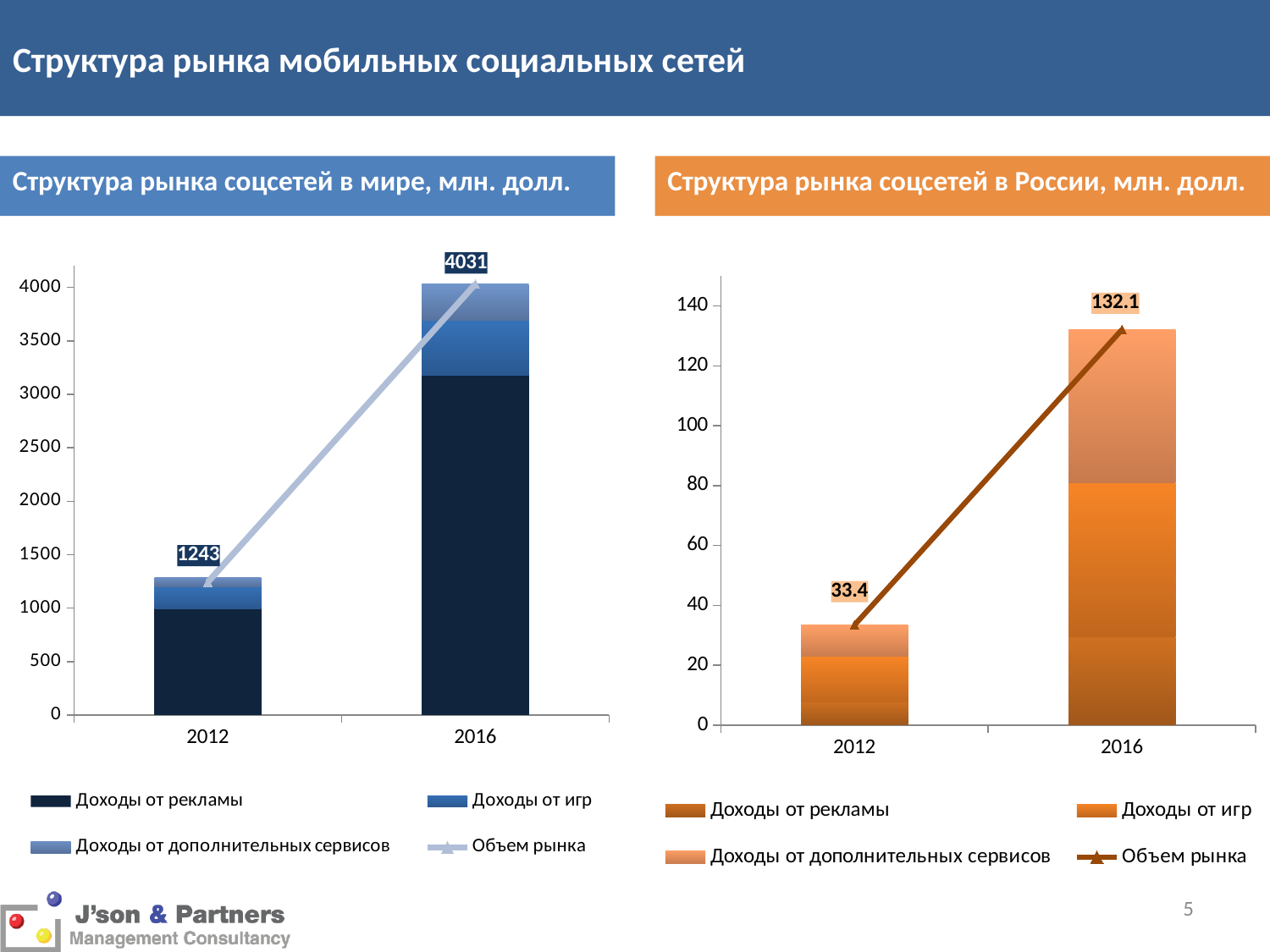
On the chart 'Структура рынка соцсетей в мире, млн. долл.', is the value of Доходы от рекламы for 2016 greater or less than 3000? greater On the chart 'Структура рынка соцсетей в России, млн. долл.', what is the value of Объем рынка for 2016? 132.1 On the chart 'Структура рынка соцсетей в мире, млн. долл.', what is the value of Объем рынка for 2012? 1243 On the chart 'Структура рынка соцсетей в России, млн. долл.', what is the value of Объем рынка for 2012? 33.4 On the chart 'Структура рынка соцсетей в России, млн. долл.', is the value of Доходы от рекламы for 2016 greater or less than 40? less How many years are shown on the x axis of the chart 'Структура рынка соцсетей в мире, млн. долл.'? 2 On the chart 'Структура рынка соцсетей в России, млн. долл.', which year has the higher Объем рынка? 2016 On the chart 'Структура рынка соцсетей в России, млн. долл.', what is the difference between Объем рынка in 2016 and in 2012? 98.7 How many series does the legend of the chart 'Структура рынка соцсетей в России, млн. долл.' list? 4 On the chart 'Структура рынка соцсетей в мире, млн. долл.', does Объем рынка rise or fall from 2012 to 2016? rise On the chart 'Структура рынка соцсетей в мире, млн. долл.', what is the value of Объем рынка for 2016? 4031 On the chart 'Структура рынка соцсетей в мире, млн. долл.', by how much does Объем рынка in 2016 exceed that in 2012? 2788